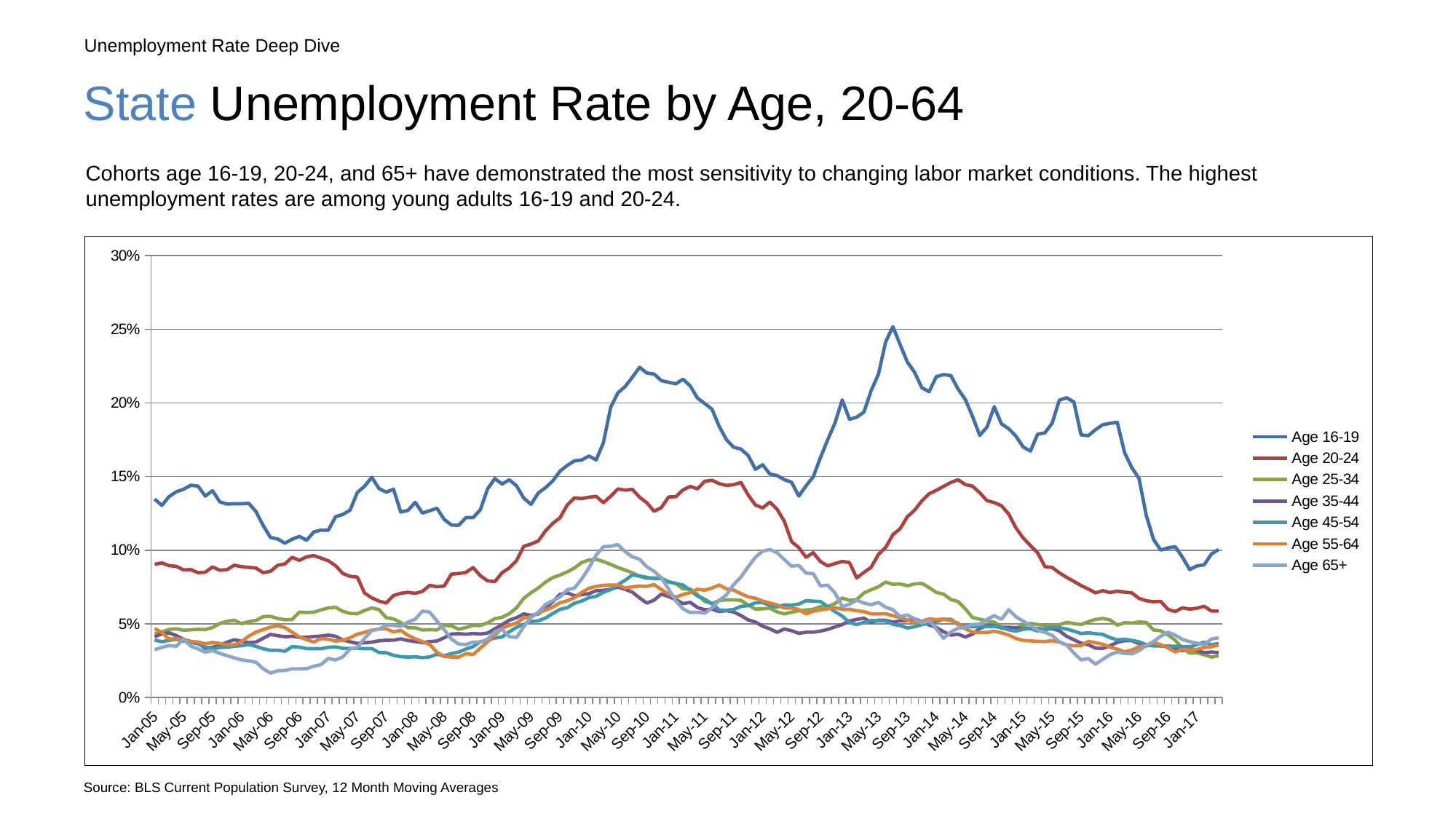
What is the highest value shown on the vertical axis? 30% Which age group has the lowest unemployment rate at May-06? Age 65+ Is the value for Age 65+ at May-06 greater or less than 5%? less Is the value for Age 65+ at Jan-12 greater or less than 5%? greater Is the value for Age 20-24 at Jan-05 greater or less than 10%? less At Jan-13, which is larger: the value for Age 16-19 or the value for Age 20-24? Age 16-19 What kind of chart is shown on the slide? line chart Which age group reaches the highest unemployment rate at any point in the chart? Age 16-19 How many series does the legend list? 7 Does the Age 16-19 line rise or fall between Jan-16 and Jan-17? fall